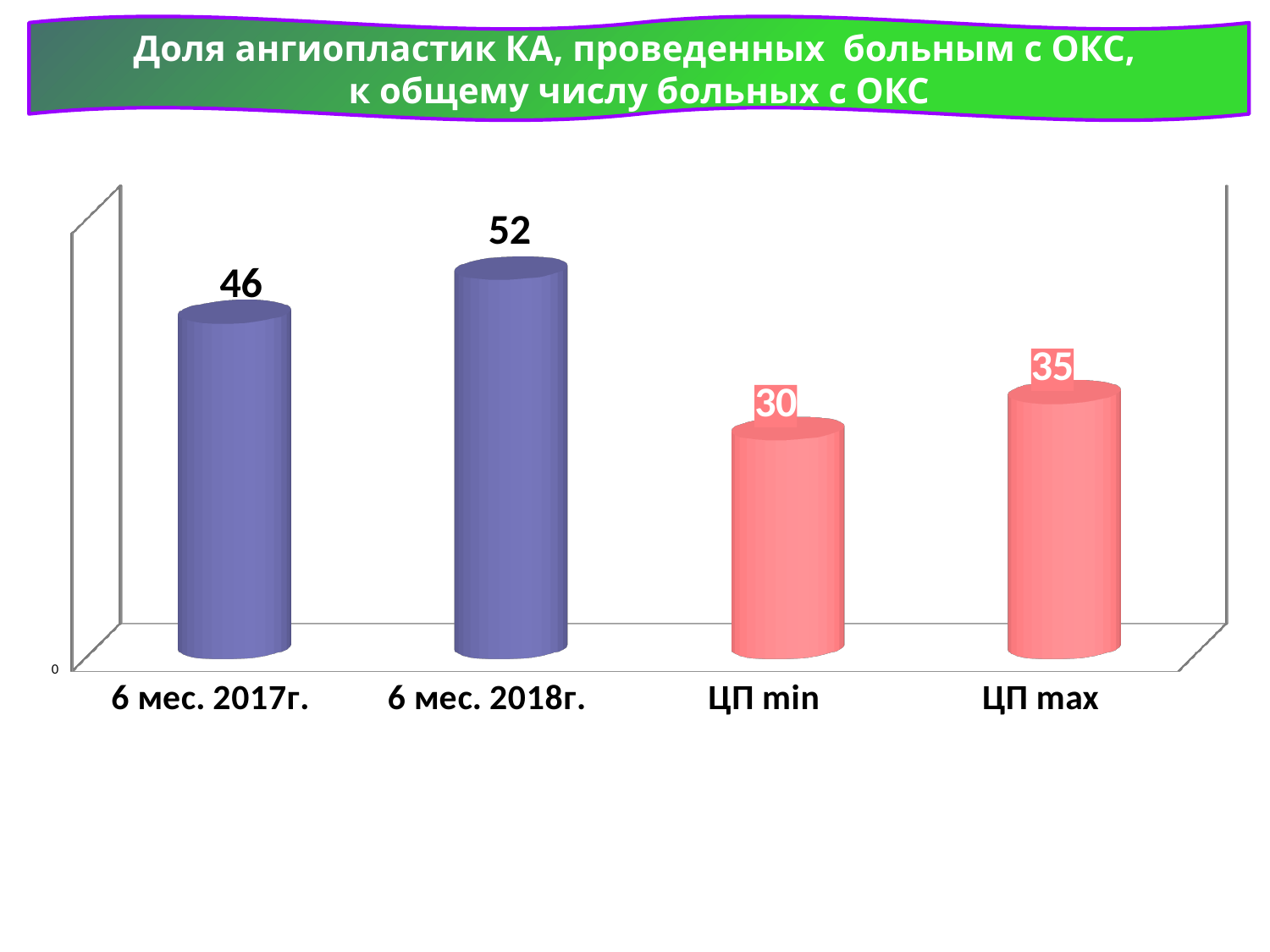
What kind of chart is shown on the slide? bar chart What is the value for 6 мес. 2018г.? 52 What is the title of the chart? Доля ангиопластик КА, проведенных больным с ОКС, к общему числу больных с ОКС What is the value for ЦП max? 35 Which category has the highest value? 6 мес. 2018г. Which is larger, the value for 6 мес. 2017г. or the value for ЦП max? 6 мес. 2017г. Which category has the lowest value? ЦП min How many categories are shown on the chart? 4 What is the value for 6 мес. 2017г.? 46 What is the value for ЦП min? 30 What is the difference between the values for ЦП max and ЦП min? 5 What is the difference between the values for 6 мес. 2018г. and 6 мес. 2017г.? 6